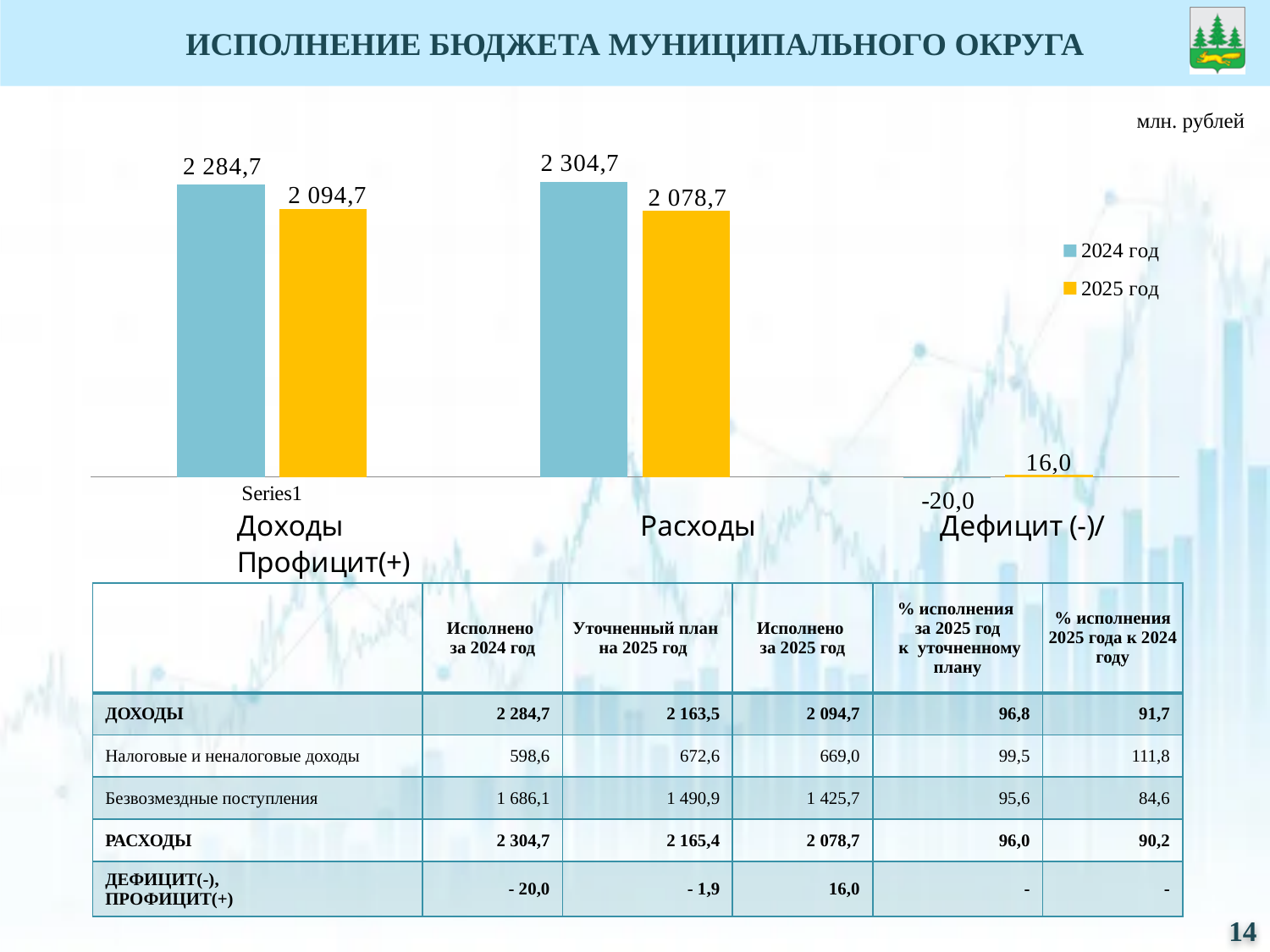
Which category has the lowest value in the 2025 год series? Дефицит (-)/Профицит(+) How many series does the legend list? 2 What is the value for Доходы in the 2024 год series? 2 284,7 What is the value for Расходы in the 2025 год series? 2 078,7 Which is larger for 2025 год: Доходы or Расходы? Доходы What is the value for Дефицит (-)/Профицит(+) in the 2024 год series? -20,0 What is the difference between the 2024 год and 2025 год values for Расходы? 226,0 What is the value for Дефицит (-)/Профицит(+) in the 2025 год series? 16,0 What unit is stated for the chart values? млн. рублей Which category has the highest value in the 2024 год series? Расходы What is the difference between the 2024 год and 2025 год values for Доходы? 190,0 What kind of chart is shown on the slide? Bar chart